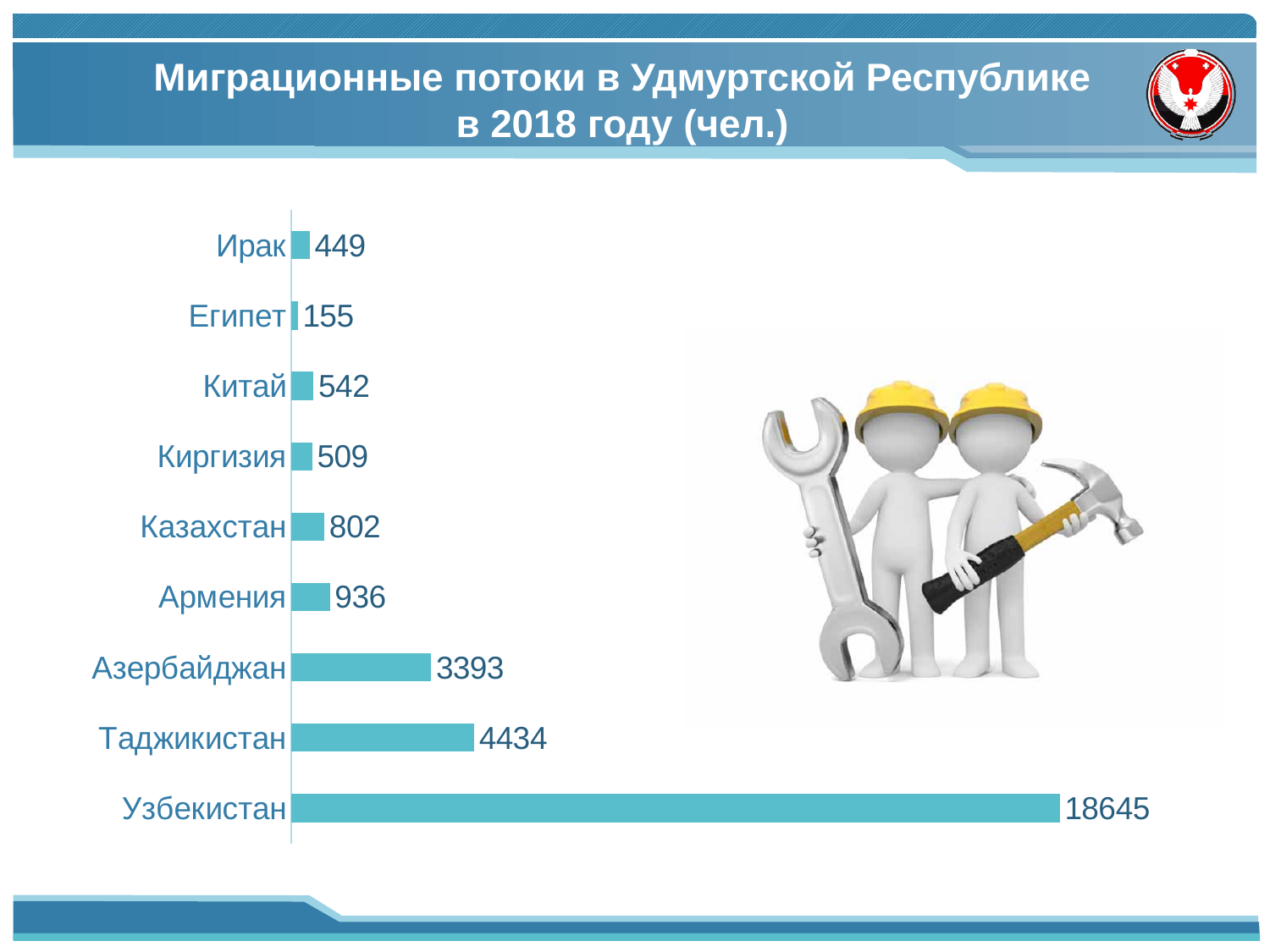
What kind of chart is shown on the slide? bar chart Which is larger, the value for Армения or the value for Казахстан? Армения Which country has the highest value? Узбекистан What is the difference between the values for Киргизия and Ирак? 60 What is the value for Египет? 155 Which is larger, the value for Китай or the value for Ирак? Китай What is the value for Узбекистан? 18645 What is the difference between the values for Таджикистан and Азербайджан? 1041 What is the value for Таджикистан? 4434 Which country has the lowest value? Египет How many countries are shown in the chart? 9 What is the title of the slide? Миграционные потоки в Удмуртской Республике в 2018 году (чел.)